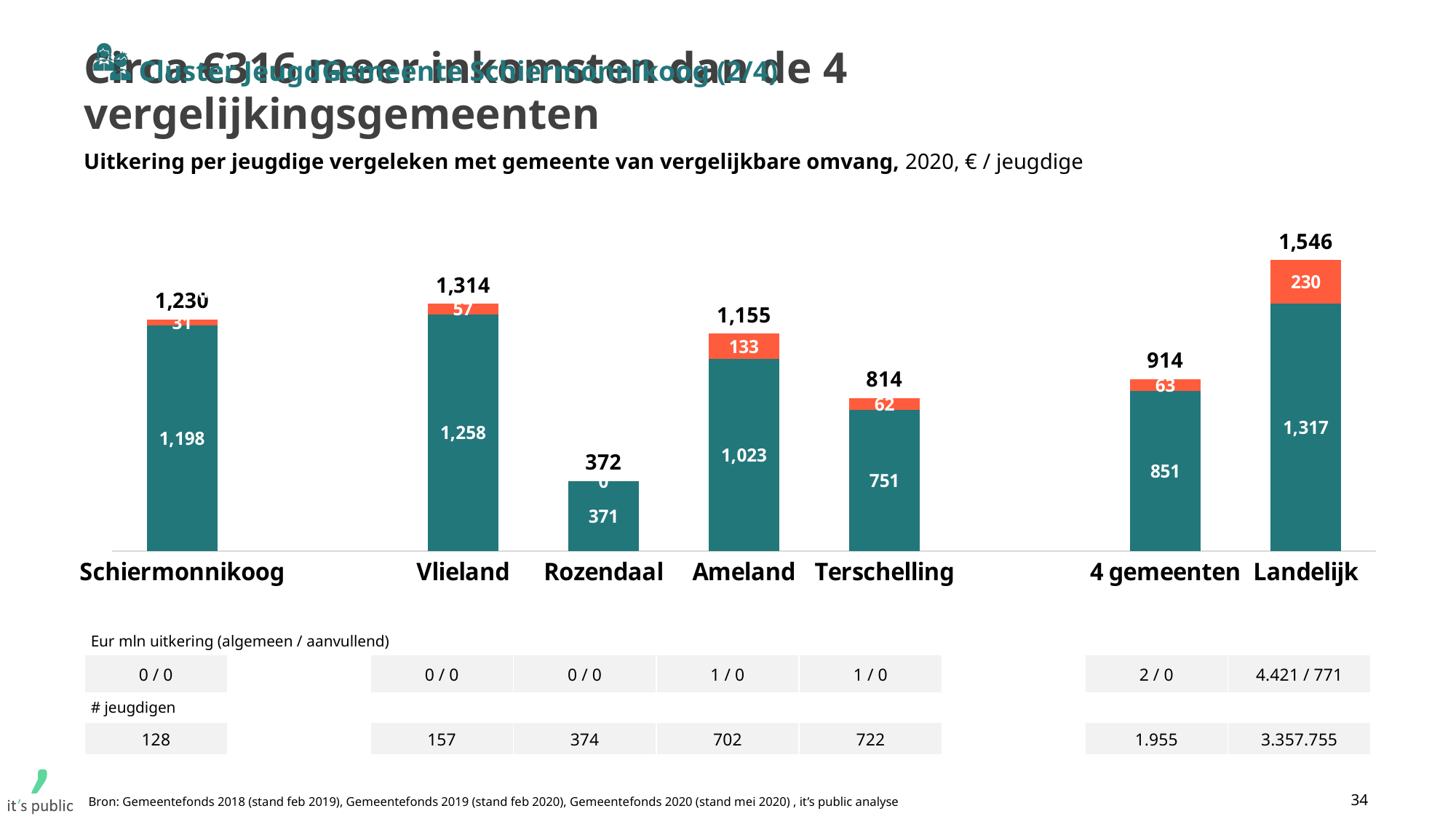
What is the difference between the teal segment for Ameland and the teal segment for Terschelling? 272 Which category has the lowest total value? Rozendaal Which has a larger total value, Vlieland or Ameland? Vlieland What is the total value printed above the Landelijk bar? 1,546 What is the total value printed above the Terschelling bar? 814 What is the difference between the total for Landelijk and the total for 4 gemeenten? 632 What is the value of the orange (top) segment for Ameland? 133 What is the value of the orange (top) segment for Rozendaal? 0 What is the value of the teal (bottom) segment for Vlieland? 1,258 How many categories are shown on the x axis of the chart? 7 Which category has the highest total value? Landelijk What kind of chart is shown on the slide? Stacked bar chart